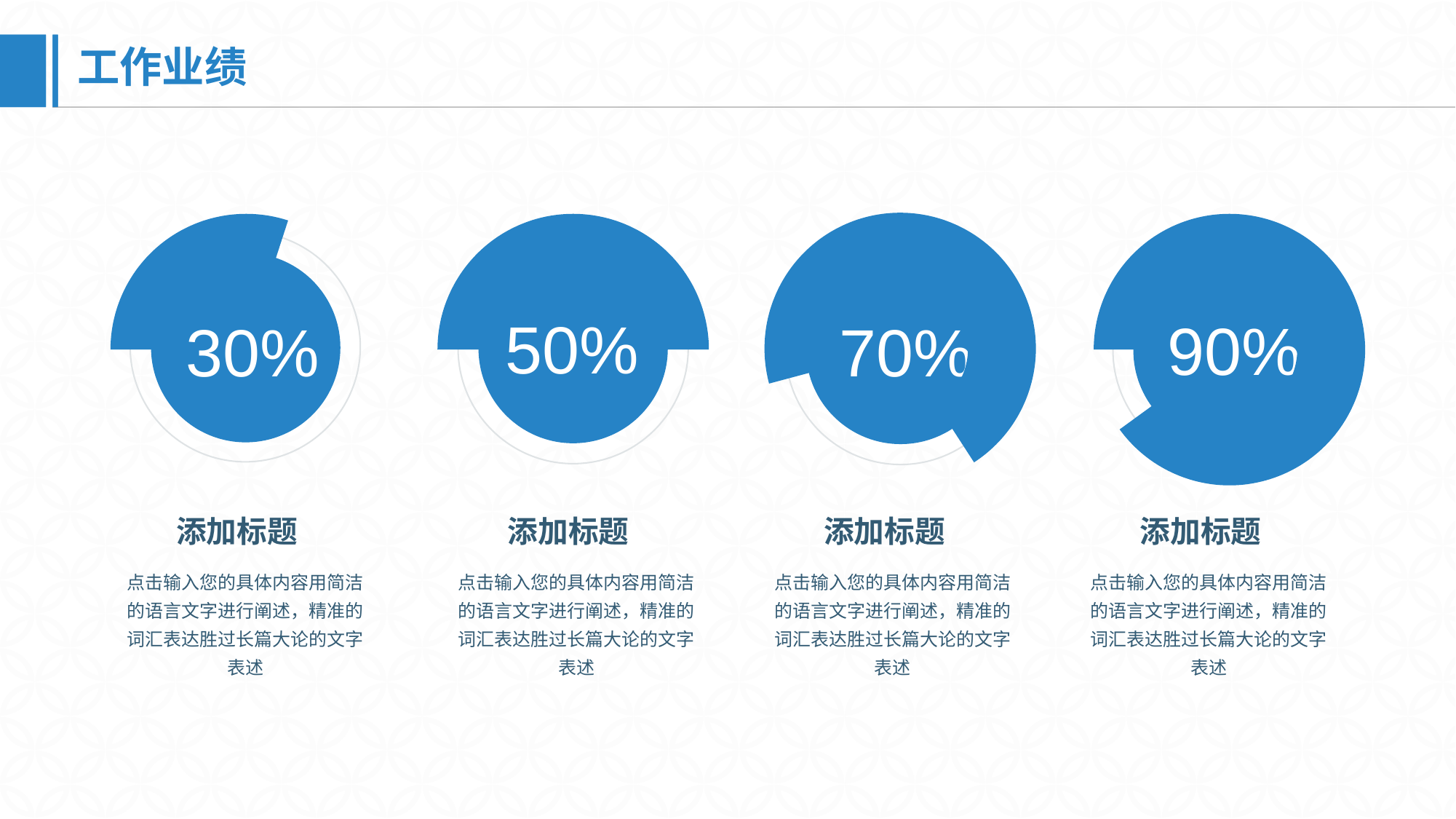
Which chart shows the lowest percentage? The leftmost chart (30%) What is the difference between the percentage in the third chart and the percentage in the second chart? 20% What percentage is shown in the rightmost chart? 90% Which chart shows the highest percentage? The rightmost chart (90%) What is the title of the slide? 工作业绩 What is the difference between the percentage in the rightmost chart and the percentage in the leftmost chart? 60% How many circular percentage charts are on the slide? 4 What kind of chart is used to show each percentage on the slide? Pie chart What percentage is shown in the leftmost chart? 30% What percentage is shown in the second chart from the left? 50% Which is larger, the percentage in the second chart or the percentage in the third chart? The third chart (70%) What percentage is shown in the third chart from the left? 70%